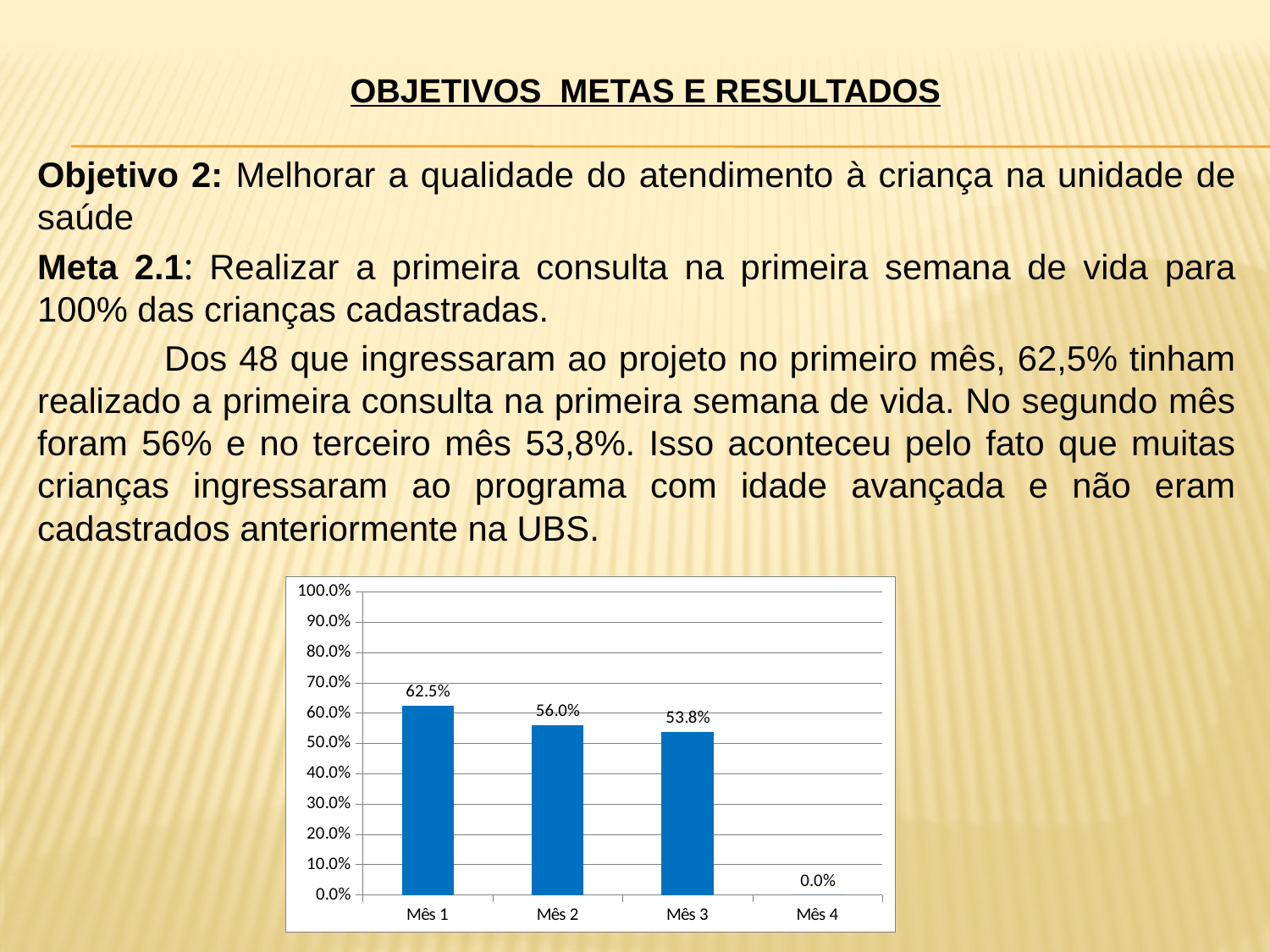
Do the values rise or fall from Mês 1 to Mês 4? fall Which category has the highest value? Mês 1 How many categories are shown on the x axis? 4 Which is larger, the value for Mês 2 or the value for Mês 3? Mês 2 What is the value for Mês 2? 56.0% What is the value for Mês 3? 53.8% What is the difference between the values for Mês 1 and Mês 3? 8.7% What is the value for Mês 1? 62.5% Which category has the lowest value? Mês 4 What kind of chart is shown on the slide? bar chart What is the value for Mês 4? 0.0% Is the value for Mês 1 greater or less than 60.0%? greater